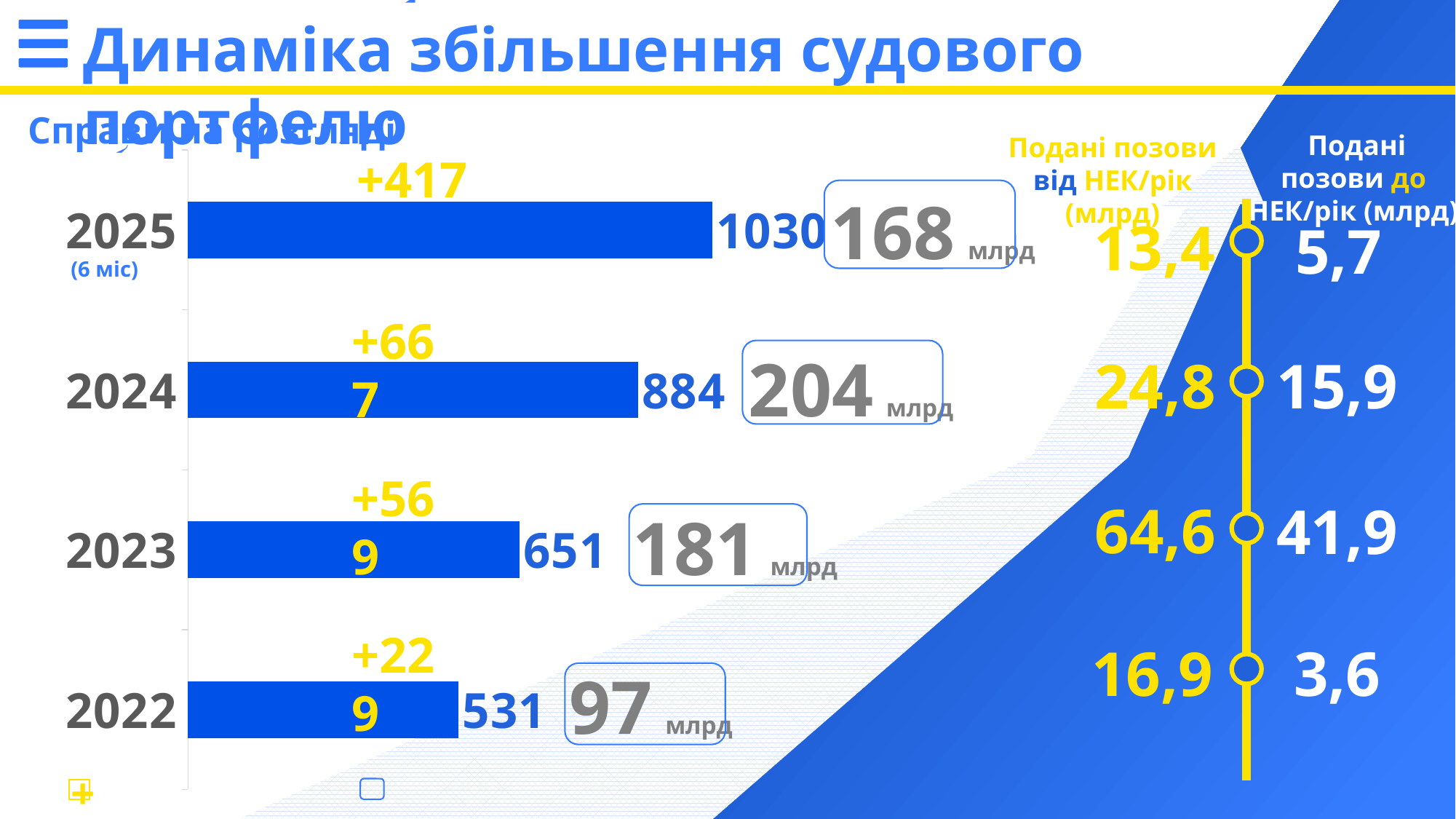
Do the bar values rise or fall from 2022 to 2025? rise How many years (bars) are shown in the bar chart? 4 What is the difference between the bar values for 2024 and 2023? 233 What is the value of the bar for 2025 in the bar chart? 1030 What kind of chart is shown on the slide? bar chart What amount in млрд is shown in the box next to the 2024 bar? 204 млрд Which year has the highest bar value in the bar chart? 2025 Which year has the lowest bar value in the bar chart? 2022 Which bar is larger, 2023 or 2024? 2024 What is the value of the bar for 2022 in the bar chart? 531 What is the value of the bar for 2023 in the bar chart? 651 What is the difference between the bar values for 2025 and 2024? 146